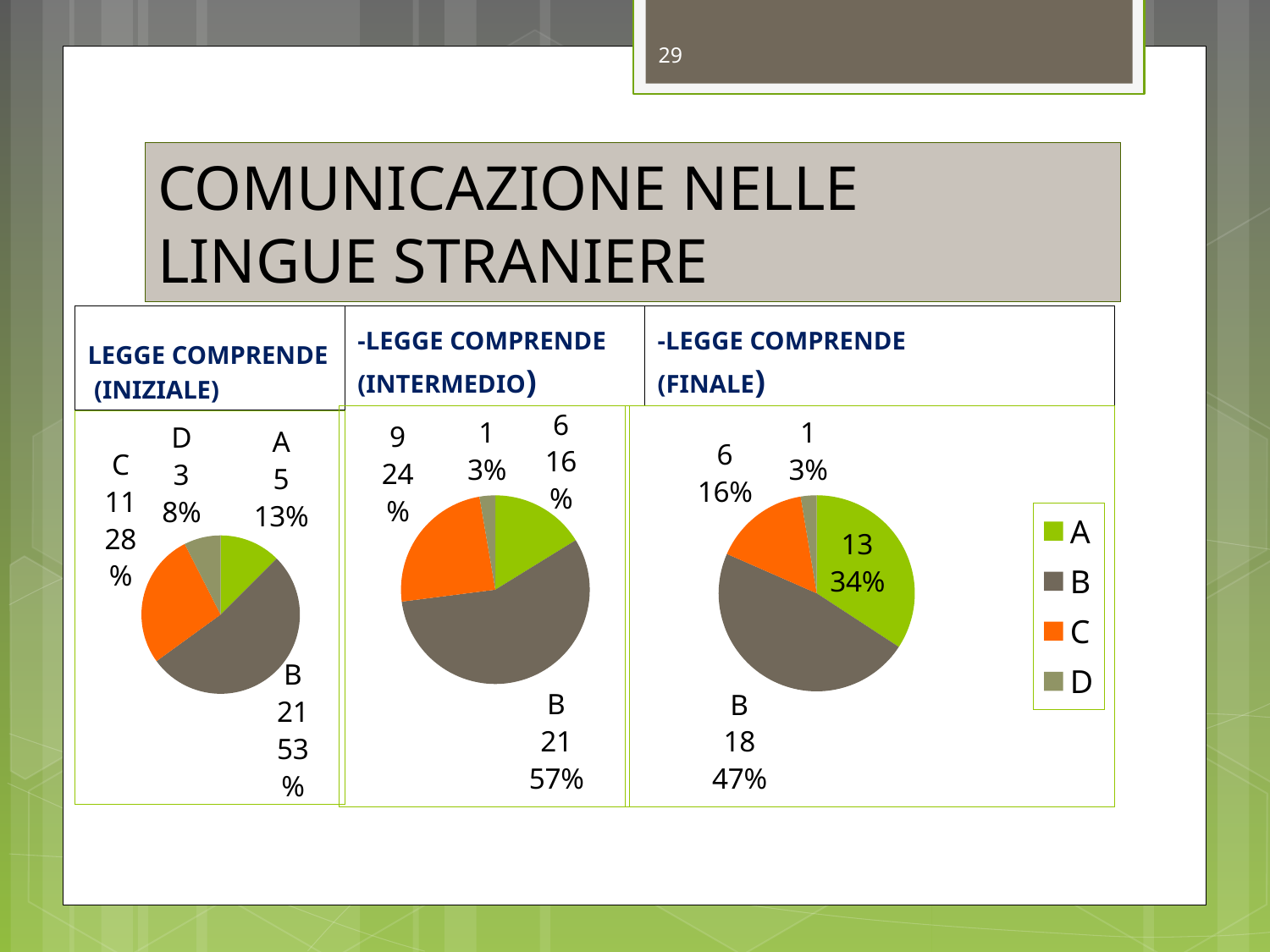
In the LEGGE COMPRENDE (FINALE) chart, what is the difference between the counts for B and A? 5 In the LEGGE COMPRENDE (FINALE) chart, what is the count shown for B? 18 How many categories does the legend on the right of the slide list? 4 In the LEGGE COMPRENDE (INTERMEDIO) chart, what percentage share does B have? 57% In the LEGGE COMPRENDE (INIZIALE) chart, what is the count shown for B? 21 In the LEGGE COMPRENDE (INIZIALE) chart, which category has the smallest slice? D In the LEGGE COMPRENDE (INTERMEDIO) chart, what is the count shown for B? 21 In the LEGGE COMPRENDE (FINALE) chart, what percentage share does A have? 34% Which is larger: the count for A in the LEGGE COMPRENDE (FINALE) chart or the count for A in the LEGGE COMPRENDE (INIZIALE) chart? FINALE What type of chart is used for the three LEGGE COMPRENDE charts on the slide? Pie chart In the LEGGE COMPRENDE (INIZIALE) chart, which category has the largest slice? B In the LEGGE COMPRENDE (INIZIALE) chart, what percentage share does C have? 28%